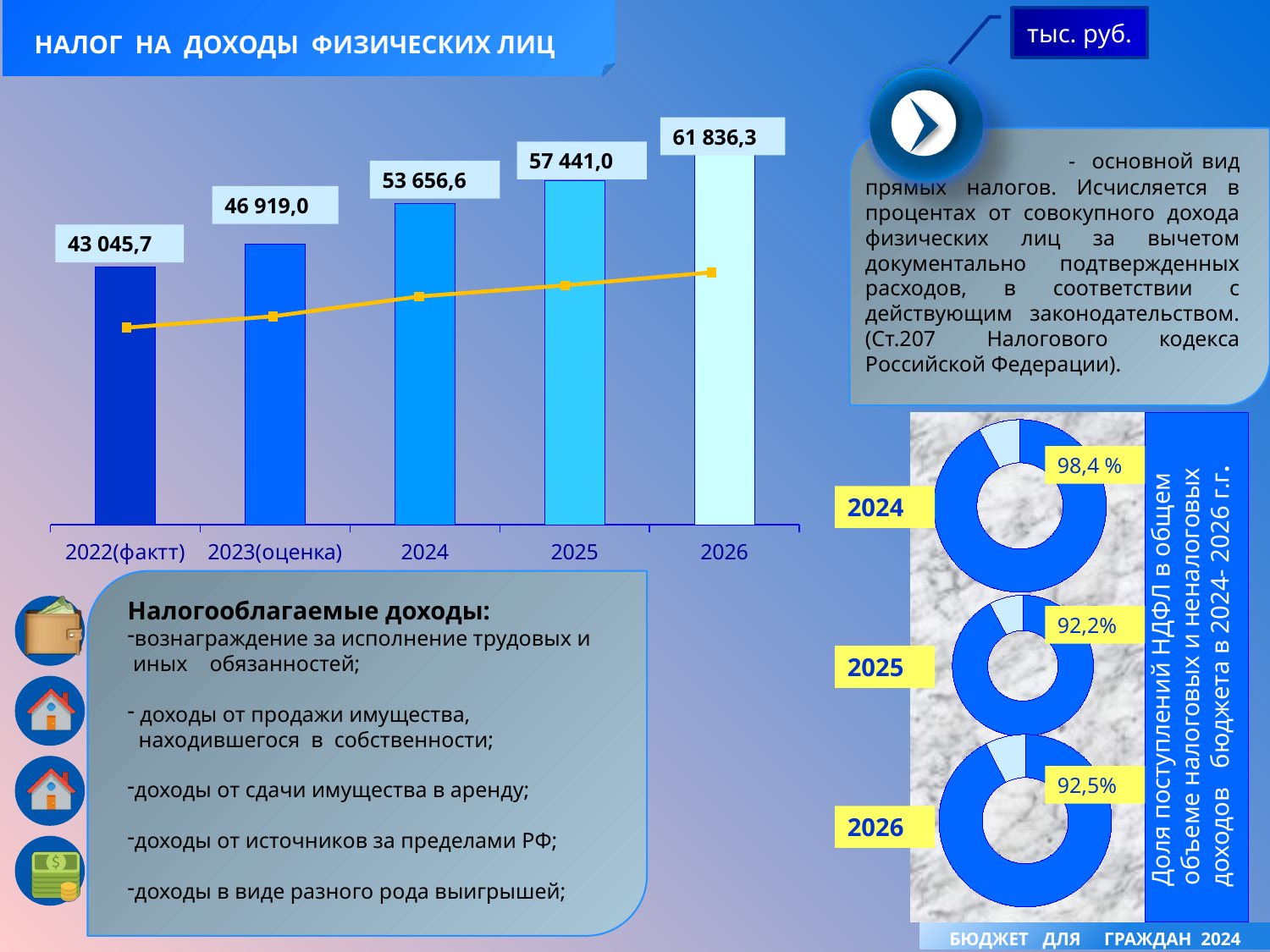
On the bar chart, what is the value for 2024? 53 656,6 What unit is indicated for the bar chart values in the box at the top right? тыс. руб. How many categories are shown on the bar chart? 5 On the donut charts on the right, what share is shown for 2025? 92,2% On the bar chart, which category has the lowest value? 2022(фактт) Do the values on the bar chart rise or fall from 2022(фактт) to 2026? rise On the bar chart, what is the value for 2026? 61 836,3 On the bar chart, what is the value for 2022(фактт)? 43 045,7 On the donut charts on the right, what share is shown for 2024? 98,4 % On the bar chart, which category has the highest value? 2026 On the bar chart, which is larger: the value for 2023(оценка) or the value for 2025? 2025 On the bar chart, what is the difference between the values for 2025 and 2024? 3 784,4